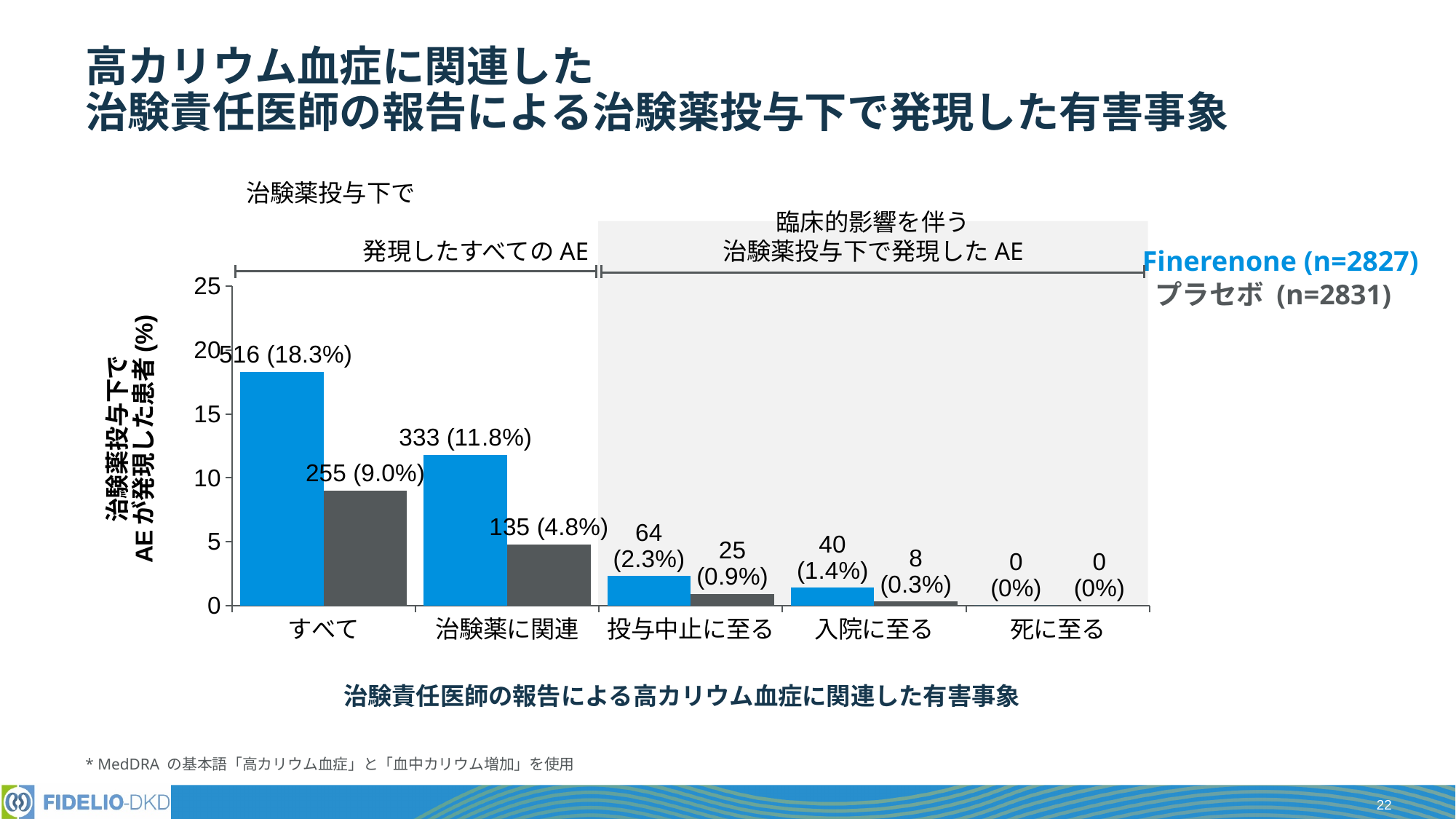
In the 治験薬に関連 category, which is larger, Finerenone or プラセボ? Finerenone What is the sample size shown for the プラセボ group in the legend? n=2831 What is the data label for プラセボ in the 治験薬に関連 category? 135 (4.8%) Which category has the lowest value for プラセボ? 死に至る What kind of chart is shown on the slide? Bar chart How many series does the legend list? 2 What is the data label for プラセボ in the 投与中止に至る category? 25 (0.9%) Which category has the highest value for Finerenone? すべて What is the data label for Finerenone in the すべて category? 516 (18.3%) What is the difference in patient count between Finerenone and プラセボ in the すべて category? 261 How many categories are shown on the x axis? 5 What is the data label for Finerenone in the 入院に至る category? 40 (1.4%)